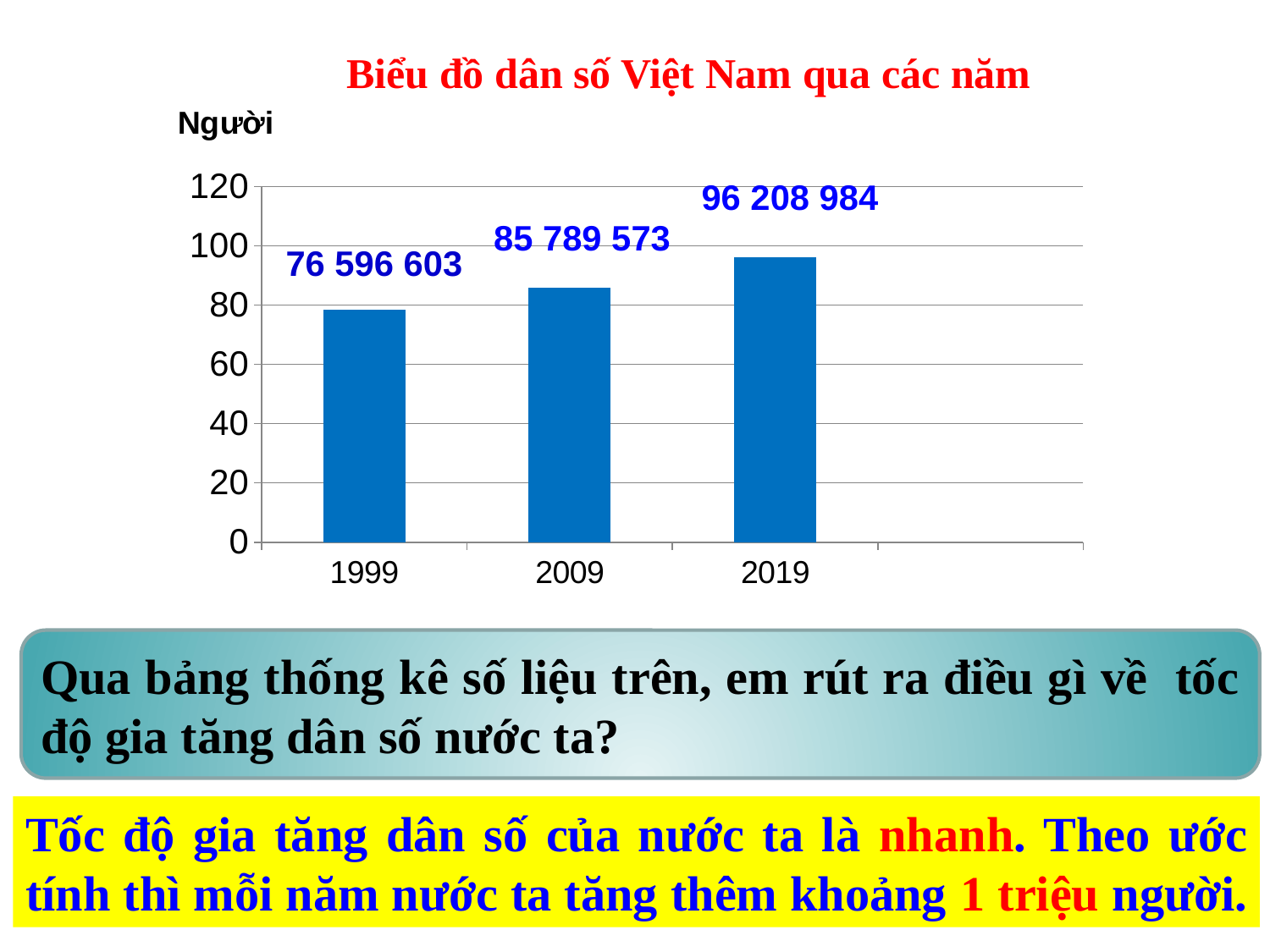
How many years are shown on the chart? 3 Which is larger, the population in 2009 or in 2019? 2019 What is the population value shown for 2009? 85 789 573 Do the population values rise or fall from 1999 to 2019? rise Which year has the lowest population on the chart? 1999 Which year has the highest population on the chart? 2019 What is the difference between the population in 2019 and in 2009? 10 419 411 What kind of chart is shown on the slide? bar chart What is the population value shown for 2019? 96 208 984 What is the population value shown for 1999? 76 596 603 Is the bar for 1999 greater or less than 80 on the axis? less What is the difference between the population in 2009 and in 1999? 9 192 970